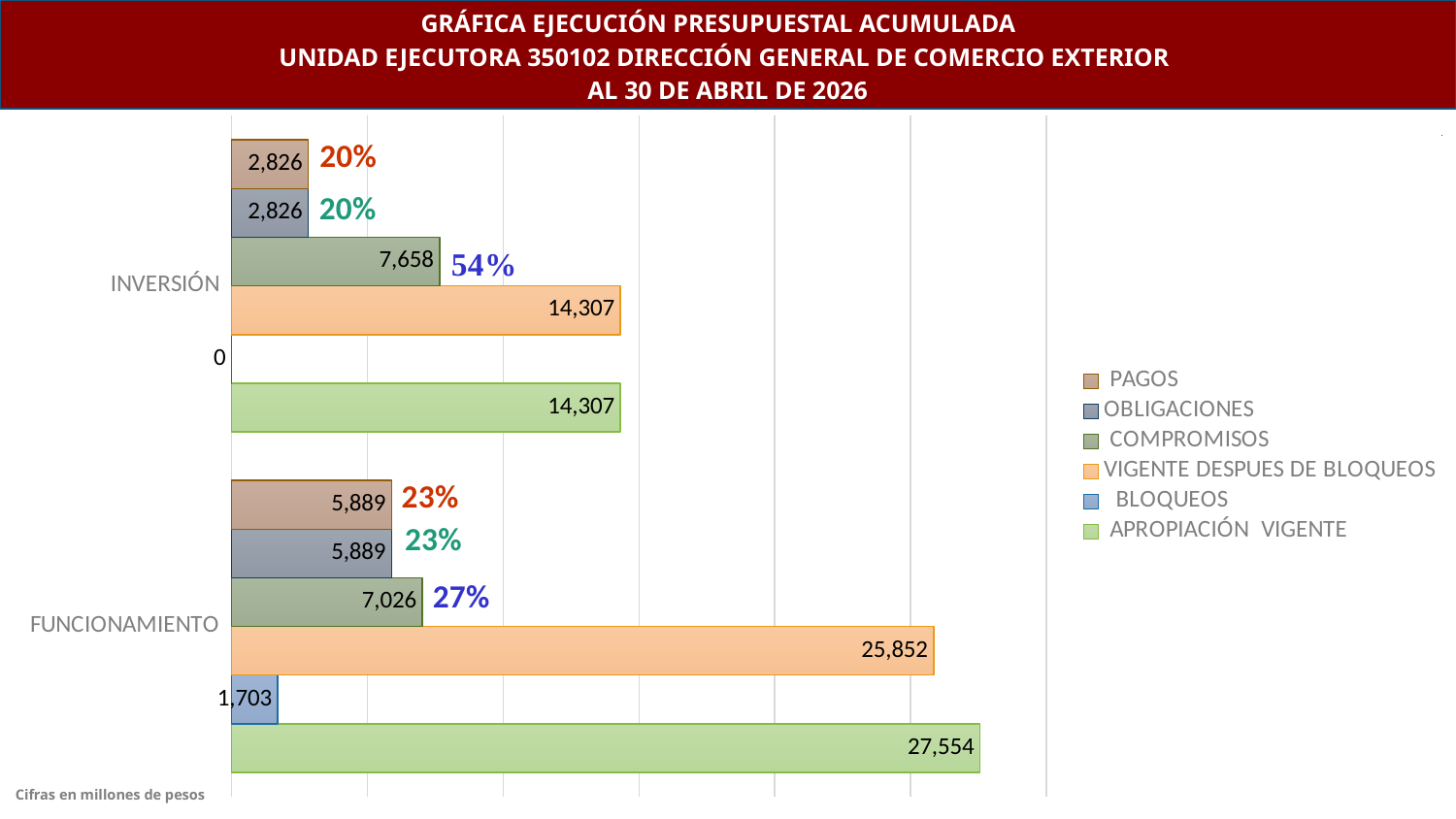
What percentage is shown next to the COMPROMISOS bar for INVERSIÓN? 54% What is the difference between APROPIACIÓN VIGENTE and VIGENTE DESPUES DE BLOQUEOS for FUNCIONAMIENTO? 1,702 What is the value of APROPIACIÓN VIGENTE for FUNCIONAMIENTO? 27,554 What is the value of BLOQUEOS for INVERSIÓN? 0 How many series does the legend list? 6 What is the value of COMPROMISOS for INVERSIÓN? 7,658 What is the value of BLOQUEOS for FUNCIONAMIENTO? 1,703 How many categories are shown on the vertical axis? 2 What unit note is printed at the bottom left of the chart? Cifras en millones de pesos Which is larger: COMPROMISOS for INVERSIÓN or COMPROMISOS for FUNCIONAMIENTO? COMPROMISOS for INVERSIÓN What type of chart is shown on the slide? Bar chart Which series has the highest value for FUNCIONAMIENTO? APROPIACIÓN VIGENTE